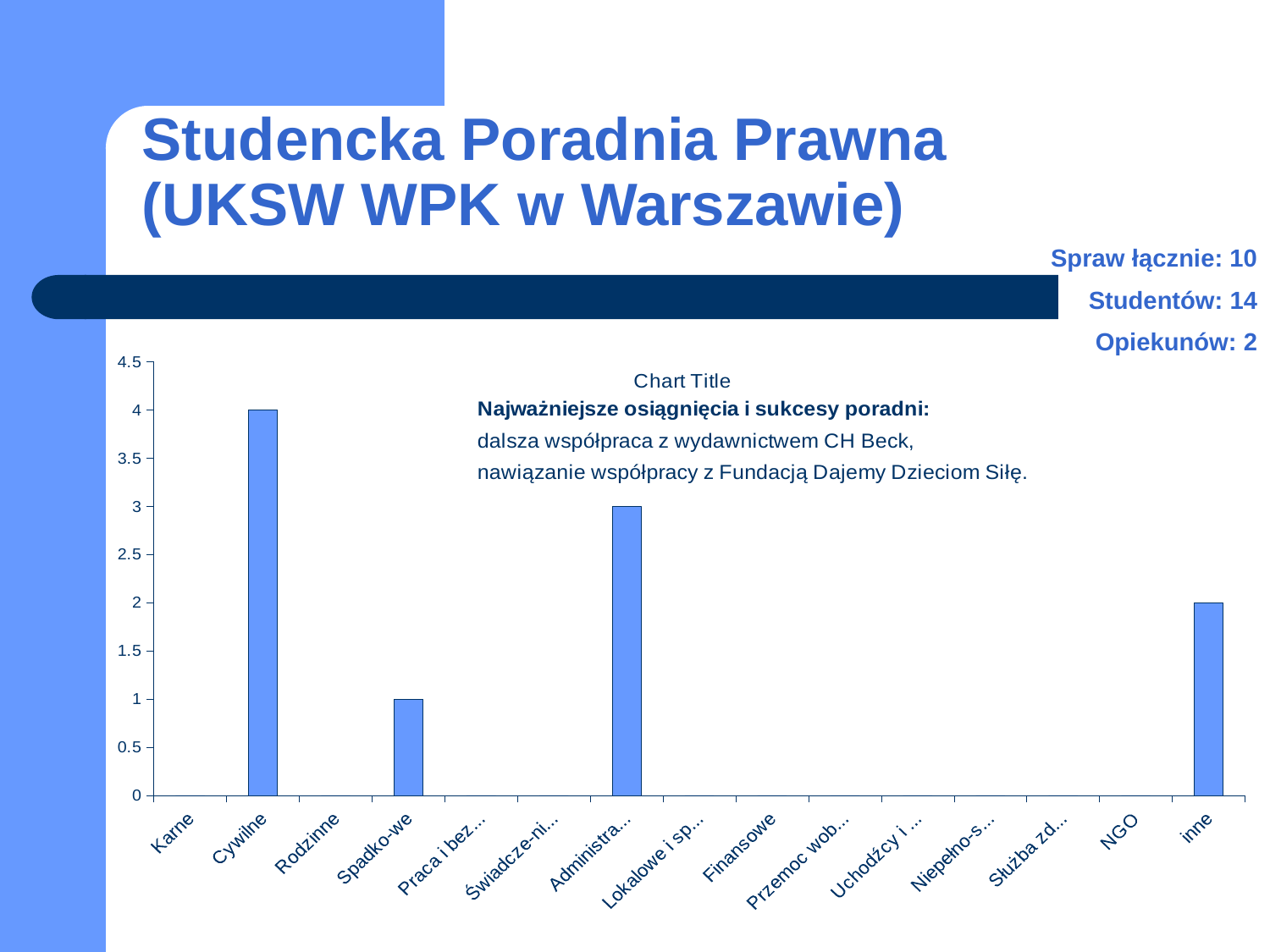
What is the value for Karne? 0 Is the value for Cywilne greater or less than 3.5? greater What is the value for Spadko-we? 1 What is the difference between the values for Cywilne and inne? 2 How many categories are shown on the x axis? 15 What is the value for Cywilne? 4 What is the title shown on the chart? Chart Title Which is larger, the value for Spadko-we or the value for inne? inne What is the highest value shown on the y axis? 4.5 What type of chart is shown on the slide? bar chart What is the value for inne? 2 Which category has the highest value? Cywilne